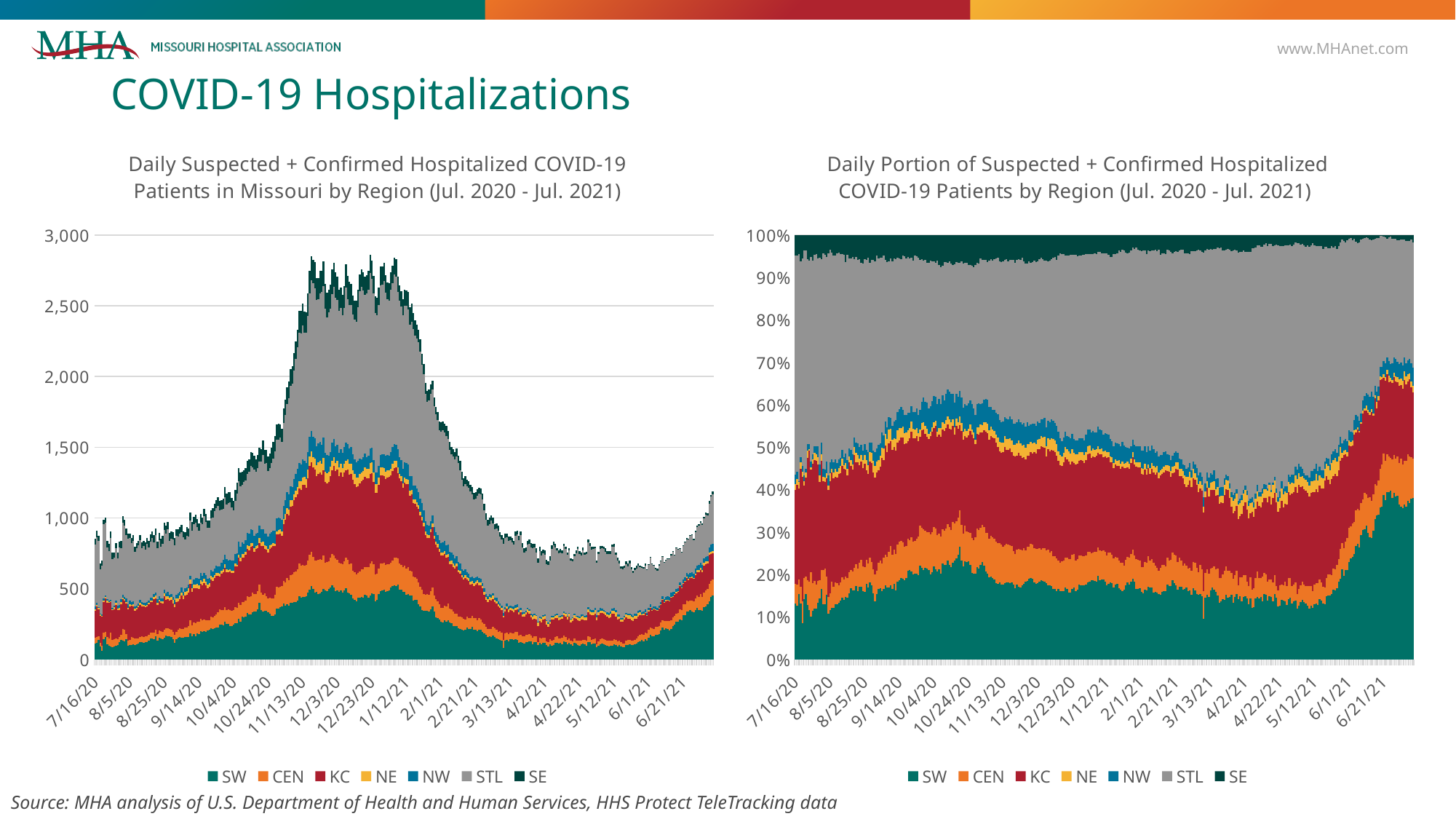
What is the highest value shown on the y-axis of the left chart? 3,000 What kind of chart is the left chart, 'Daily Suspected + Confirmed Hospitalized COVID-19 Patients in Missouri by Region'? Stacked area chart In the left chart, do total hospitalizations rise or fall between 10/4/20 and 12/3/20? rise In the left chart, which region contributes the largest number of hospitalized patients at the peak in December 2020? STL Which regions are listed in the legend of the right chart? SW, CEN, KC, NE, NW, STL, SE In the left chart, is the total number of hospitalized patients on 7/16/20 greater or less than 1,000? less In the left chart, is the total number of hospitalized patients on 6/21/21 greater or less than 1,500? less How many series does the legend of the left chart list? 7 In the right chart, which region has the largest share of hospitalized patients around 12/3/20? STL In the left chart, do total hospitalizations rise or fall between 1/12/21 and 5/12/21? fall In the left chart, is the total number of hospitalized patients at the peak around 12/3/20 greater or less than 2,500? greater